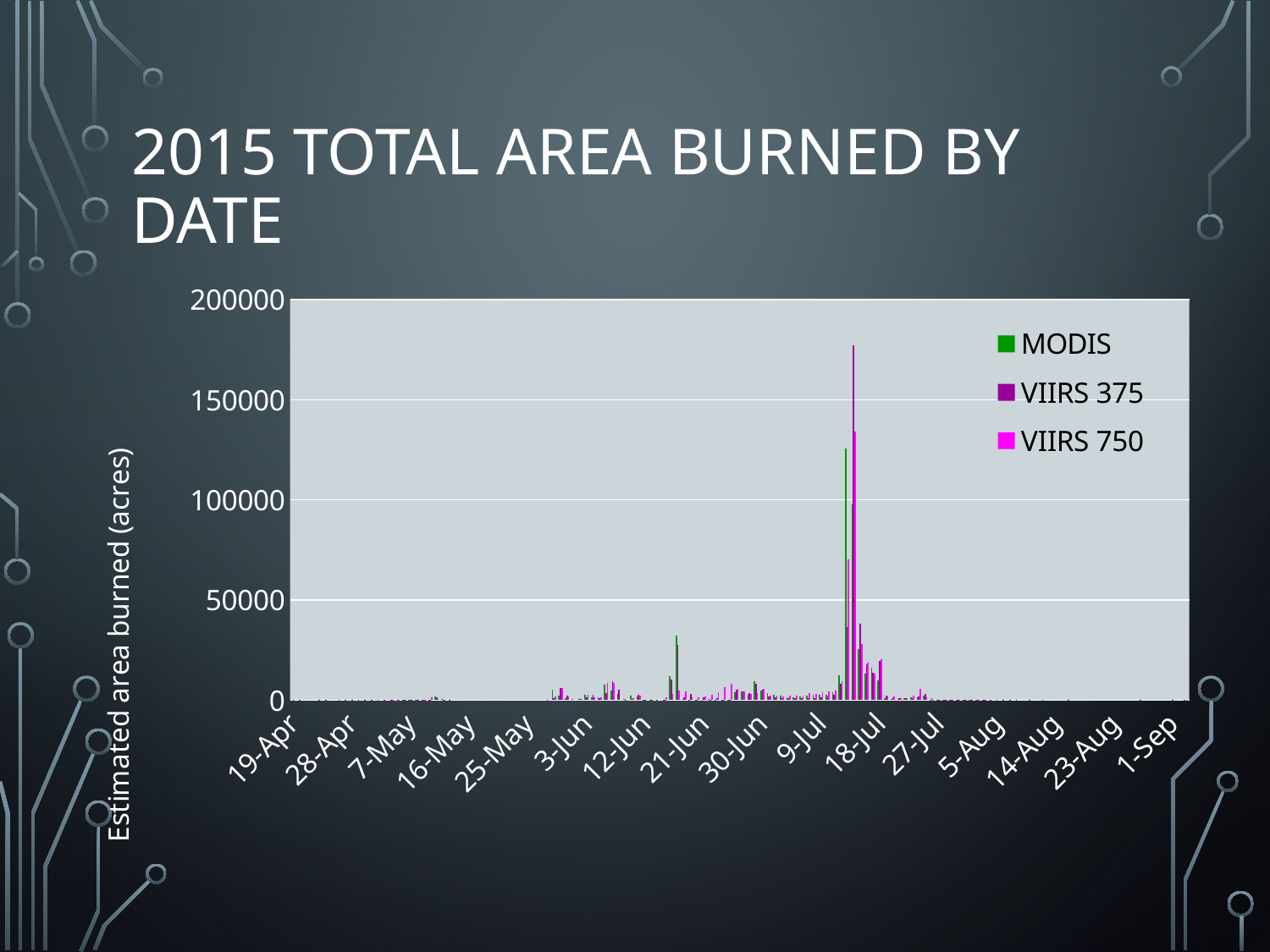
How many series does the legend list? 3 In which month does the largest spike in area burned occur? July Is the tallest VIIRS 375 bar greater or less than 150000? greater Which series has the single tallest bar in the chart? VIIRS 375 Is the tallest MODIS bar greater or less than 100000? greater What are the three series named in the legend? MODIS, VIIRS 375, VIIRS 750 Which is larger, the peak VIIRS 375 bar or the peak MODIS bar? VIIRS 375 How many date labels are shown along the x axis? 16 After the mid-July peak, do the values rise or fall toward the end of the x axis? fall What is the label on the vertical axis? Estimated area burned (acres) What kind of chart is shown on the slide? bar chart Is the tallest VIIRS 750 bar greater or less than 150000? less